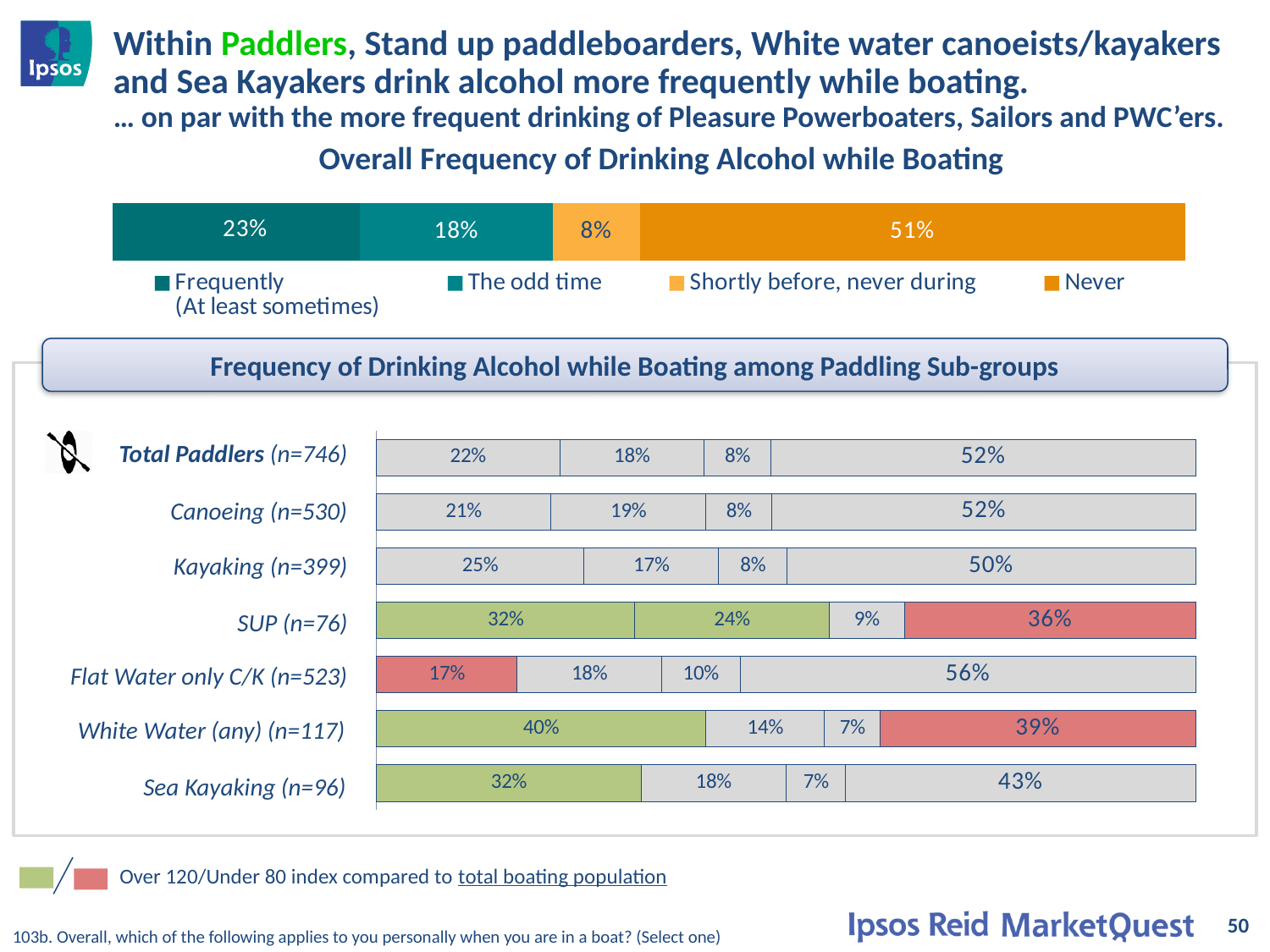
How many sub-groups (bars) are shown in the 'Frequency of Drinking Alcohol while Boating among Paddling Sub-groups' chart? 7 In the 'Overall Frequency of Drinking Alcohol while Boating' chart, what percentage is shown for 'Never'? 51% In the 'Frequency of Drinking Alcohol while Boating among Paddling Sub-groups' chart, what is the last (rightmost) segment value for Flat Water only C/K (n=523)? 56% What type of chart is the 'Frequency of Drinking Alcohol while Boating among Paddling Sub-groups' chart? Stacked bar chart How many series does the legend of the 'Overall Frequency of Drinking Alcohol while Boating' chart list? 4 In the 'Frequency of Drinking Alcohol while Boating among Paddling Sub-groups' chart, which sub-group has the highest value in the first (leftmost) segment? White Water (any) (n=117) In the 'Overall Frequency of Drinking Alcohol while Boating' chart, what percentage is shown for 'Frequently (At least sometimes)'? 23% In the 'Frequency of Drinking Alcohol while Boating among Paddling Sub-groups' chart, what is the difference between the rightmost segment values for Flat Water only C/K (n=523) and SUP (n=76)? 20% In the 'Frequency of Drinking Alcohol while Boating among Paddling Sub-groups' chart, which is larger: the leftmost segment for Kayaking (n=399) or for Canoeing (n=530)? Kayaking (n=399) In the 'Frequency of Drinking Alcohol while Boating among Paddling Sub-groups' chart, what is the second segment value for SUP (n=76)? 24% In the 'Frequency of Drinking Alcohol while Boating among Paddling Sub-groups' chart, what is the first (leftmost) segment value for White Water (any) (n=117)? 40% In the 'Frequency of Drinking Alcohol while Boating among Paddling Sub-groups' chart, which sub-group has the lowest value in the last (rightmost) segment? SUP (n=76)